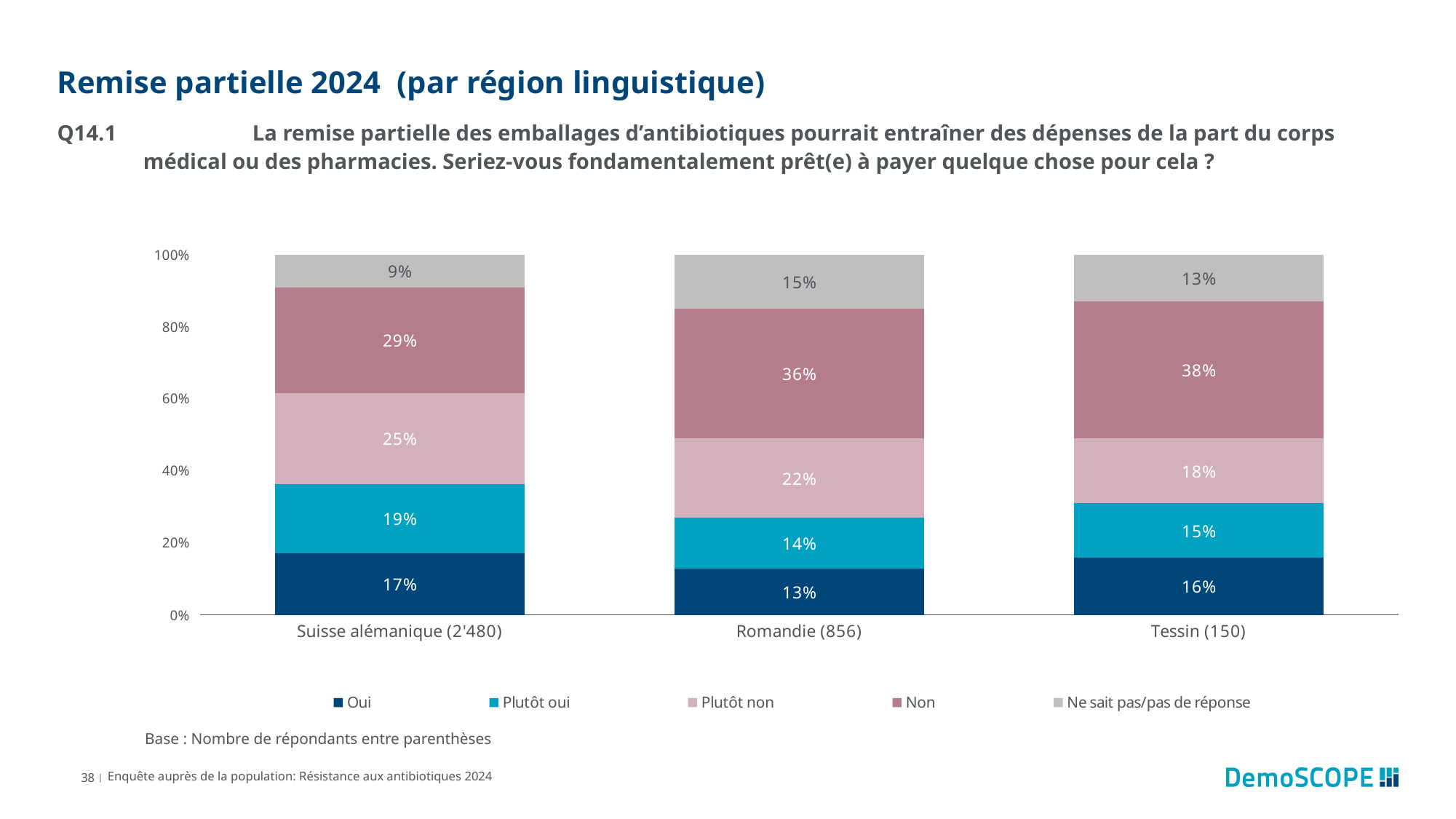
What is the value for "Ne sait pas/pas de réponse" in Suisse alémanique (2'480)? 9% How many regions are shown on the x axis? 3 What is the difference between the "Non" values for Tessin (150) and Suisse alémanique (2'480)? 9 percentage points Which is larger: "Plutôt oui" in Suisse alémanique (2'480) or "Plutôt oui" in Tessin (150)? Suisse alémanique (2'480) What is the combined value of "Oui" and "Plutôt oui" for Romandie (856)? 27% What is the value for "Non" in Romandie (856)? 36% How many series does the legend list? 5 What is the value for "Oui" in Suisse alémanique (2'480)? 17% What kind of chart is shown on the slide? Stacked bar chart Which region has the lowest value for "Plutôt oui"? Romandie (856) What is the value for "Plutôt non" in Tessin (150)? 18% Which region has the highest value for "Non"? Tessin (150)